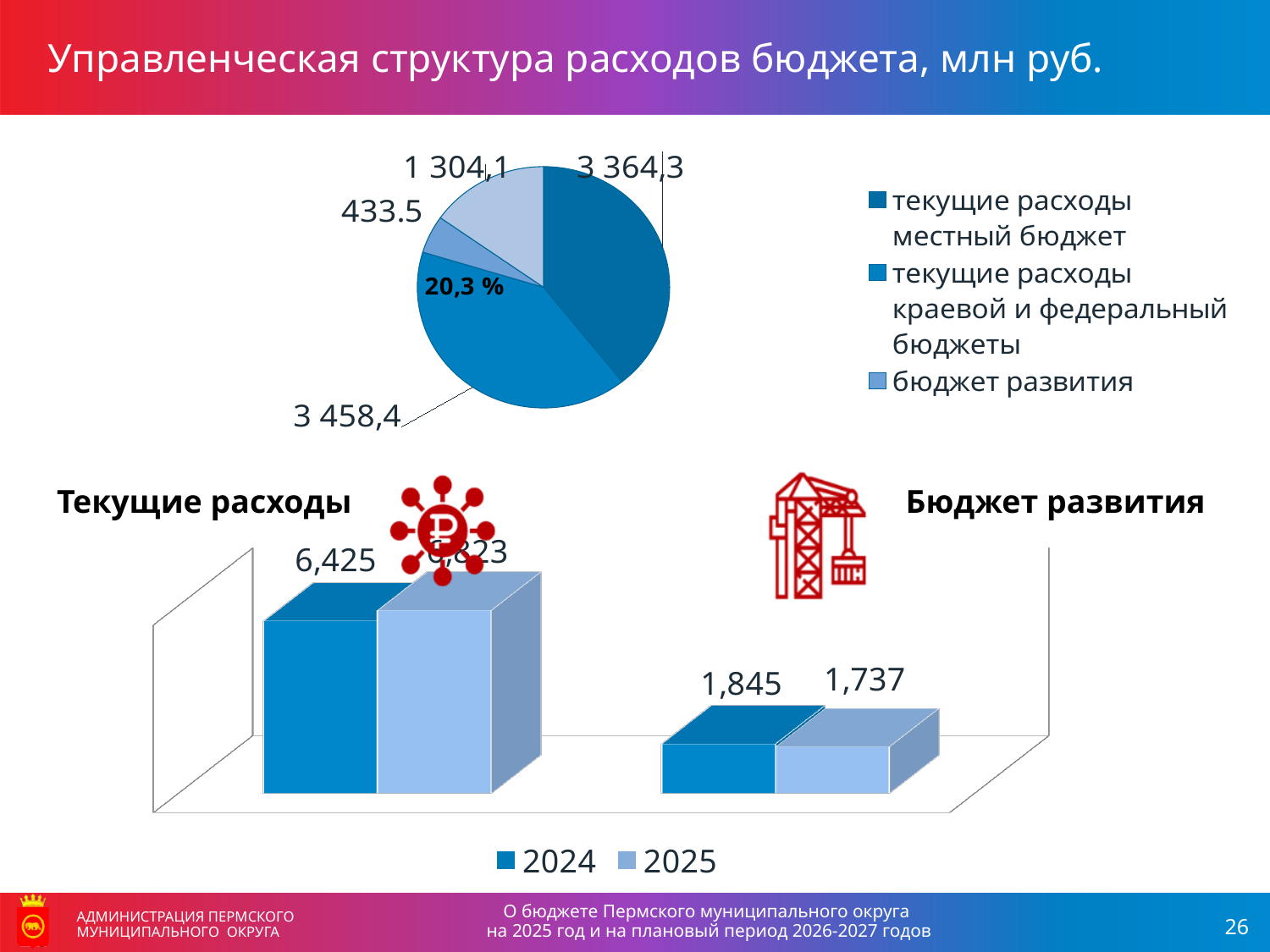
In the bottom bar chart, what is the value for Бюджет развития in 2024? 1,845 In the bottom bar chart, which year has the larger value for Текущие расходы, 2024 or 2025? 2025 What kind of chart is shown at the top of the slide? pie chart In the pie chart, what is the value of the largest slice? 3 458,4 How many entries does the legend of the pie chart list? 3 How many series does the legend of the bottom bar chart list? 2 In the bottom bar chart, what is the value for Бюджет развития in 2025? 1,737 In the bottom bar chart, what is the value for Текущие расходы in 2024? 6,425 In the bottom bar chart, what is the difference between the 2024 and 2025 values for Бюджет развития? 108 In the pie chart, what is the value of the smallest slice? 433.5 What kind of chart is shown at the bottom of the slide? bar chart In the bottom bar chart, does the value for Бюджет развития rise or fall from 2024 to 2025? fall